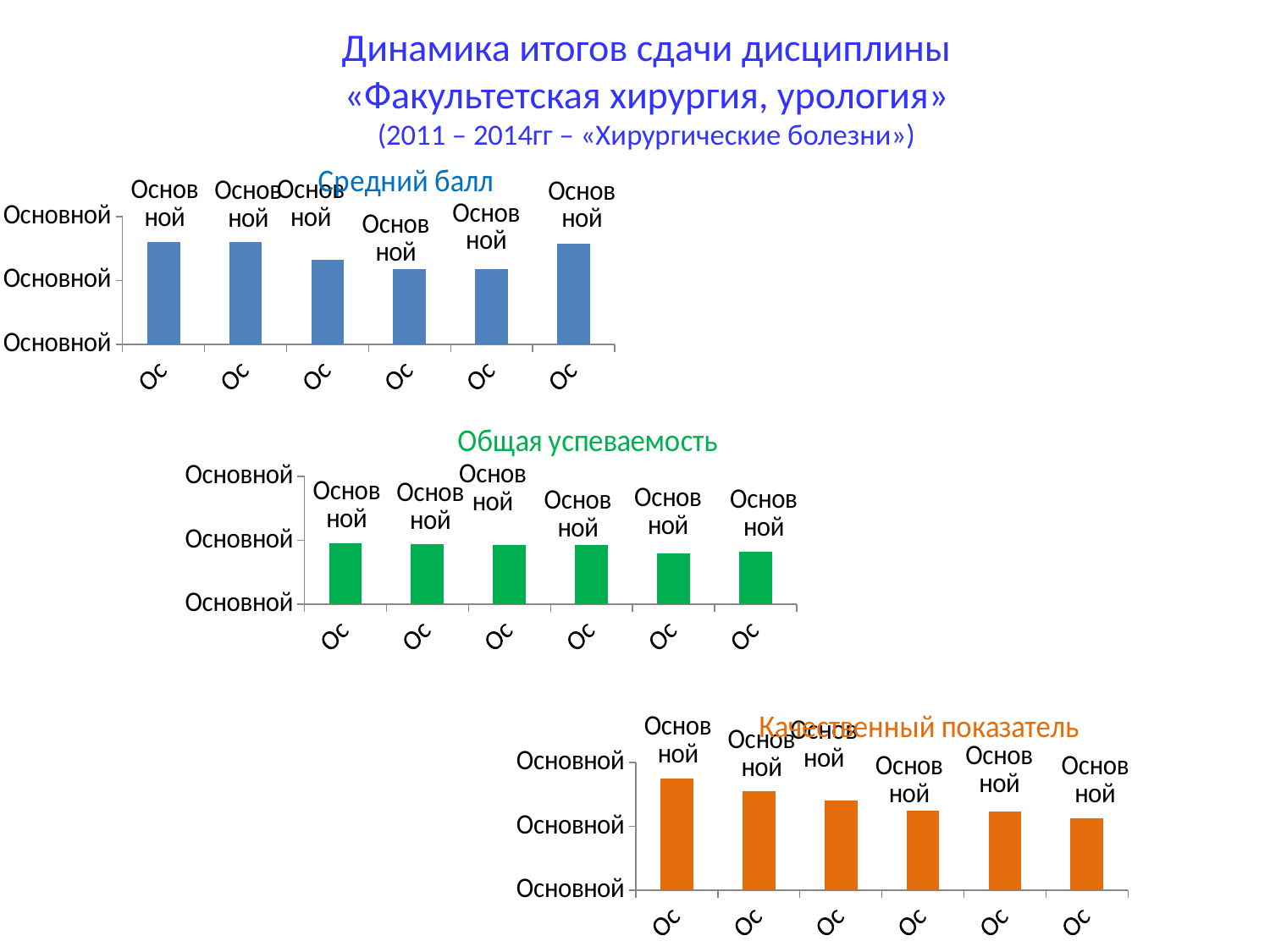
What kind of chart is the chart titled "Качественный показатель"? bar chart In the chart titled "Качественный показатель", which bar is the lowest? the last (rightmost) bar What kind of chart is the chart titled "Общая успеваемость"? bar chart In the chart titled "Средний балл", which is larger: the first (leftmost) bar or the fourth bar? the first bar In the chart titled "Качественный показатель", which bar is the highest? the first (leftmost) bar In the chart titled "Качественный показатель", do the values rise or fall from left to right? fall How many bars are plotted in the chart titled "Общая успеваемость"? 6 In the chart titled "Общая успеваемость", which is larger: the first (leftmost) bar or the fifth bar? the first bar How many charts are shown on the slide? 3 What kind of chart is the chart titled "Средний балл"? bar chart How many bars are plotted in the chart titled "Качественный показатель"? 6 How many bars are plotted in the chart titled "Средний балл"? 6